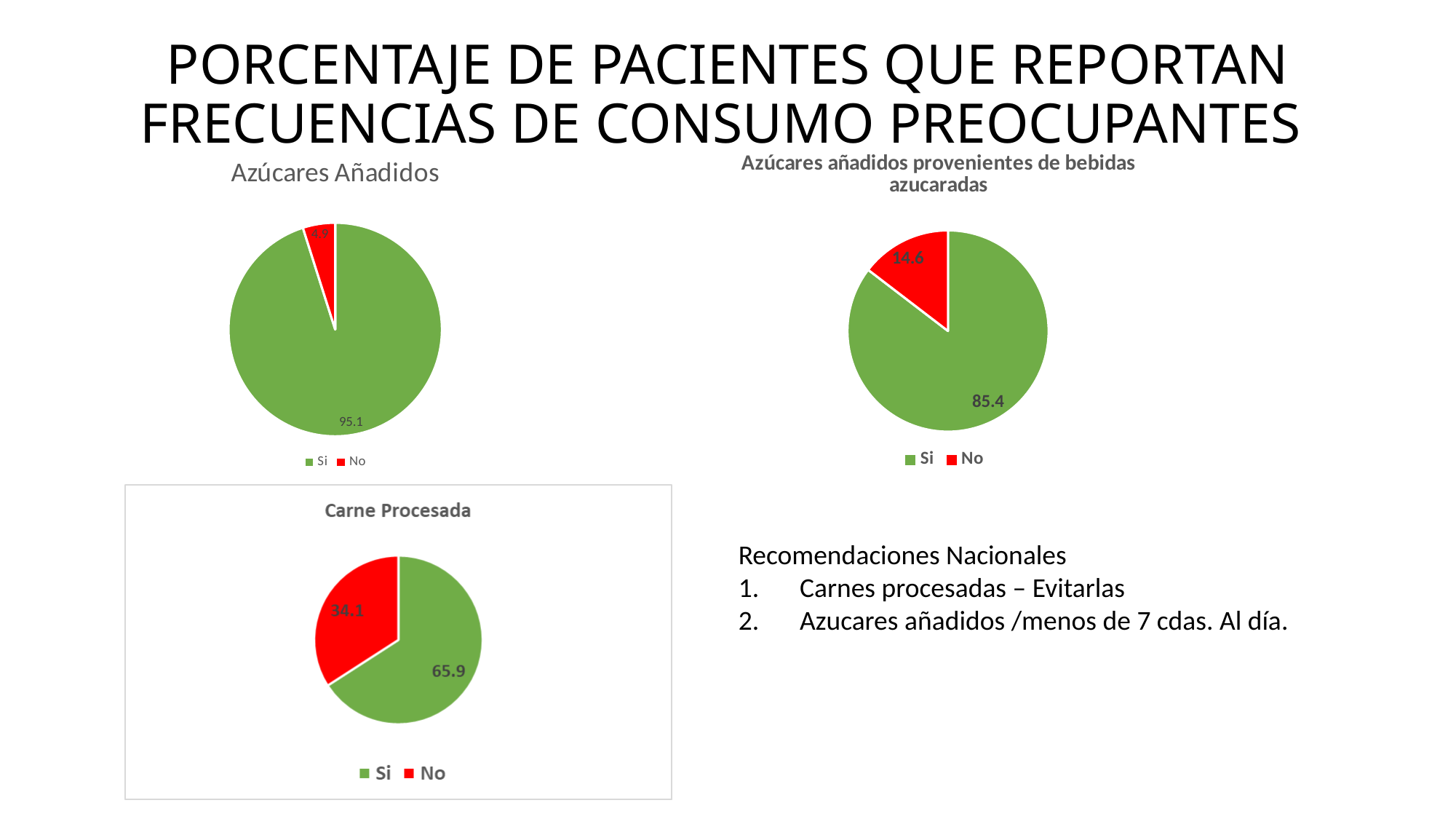
In the 'Azúcares añadidos provenientes de bebidas azucaradas' chart, which category has the smallest slice? No Which is larger in the 'Azúcares Añadidos' chart: the Si slice or the No slice? Si In the 'Carne Procesada' chart, which category has the largest slice? Si In the 'Azúcares añadidos provenientes de bebidas azucaradas' chart, what is the value for Si? 85.4 In the 'Azúcares añadidos provenientes de bebidas azucaradas' chart, what is the value for No? 14.6 How many entries does the legend of the 'Azúcares añadidos provenientes de bebidas azucaradas' chart list? 2 In the 'Carne Procesada' chart, what is the value for Si? 65.9 In the 'Carne Procesada' chart, what is the value for No? 34.1 In the 'Azúcares Añadidos' chart, what is the value for Si? 95.1 In the 'Azúcares Añadidos' chart, what is the value for No? 4.9 In the 'Carne Procesada' chart, what is the difference between the Si and No values? 31.8 What type of chart is the 'Carne Procesada' chart? Pie chart